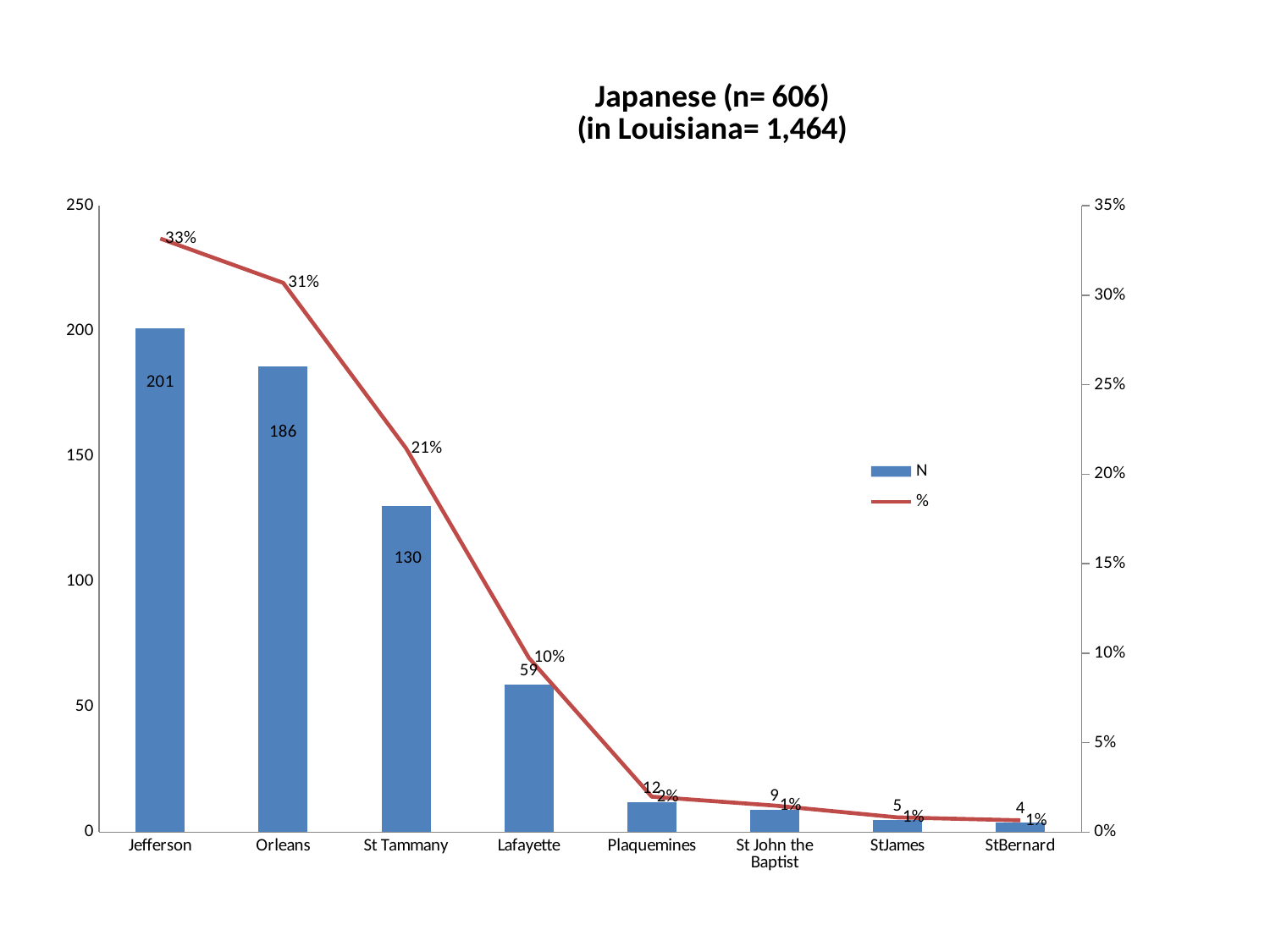
What is the N value for St Tammany? 130 What is the difference in N between Jefferson and Orleans? 15 Which has a larger N value, Plaquemines or St John the Baptist? Plaquemines How many parishes are shown on the x axis? 8 What percentage is shown for Lafayette? 10% What percentage is shown for Orleans? 31% How many series does the legend list? 2 What is the title of the chart? Japanese (n= 606) (in Louisiana= 1,464) Do the N values rise or fall from left to right along the x axis? fall Which parish has the highest N value? Jefferson What is the N value for Jefferson? 201 Which parish has the lowest N value? StBernard